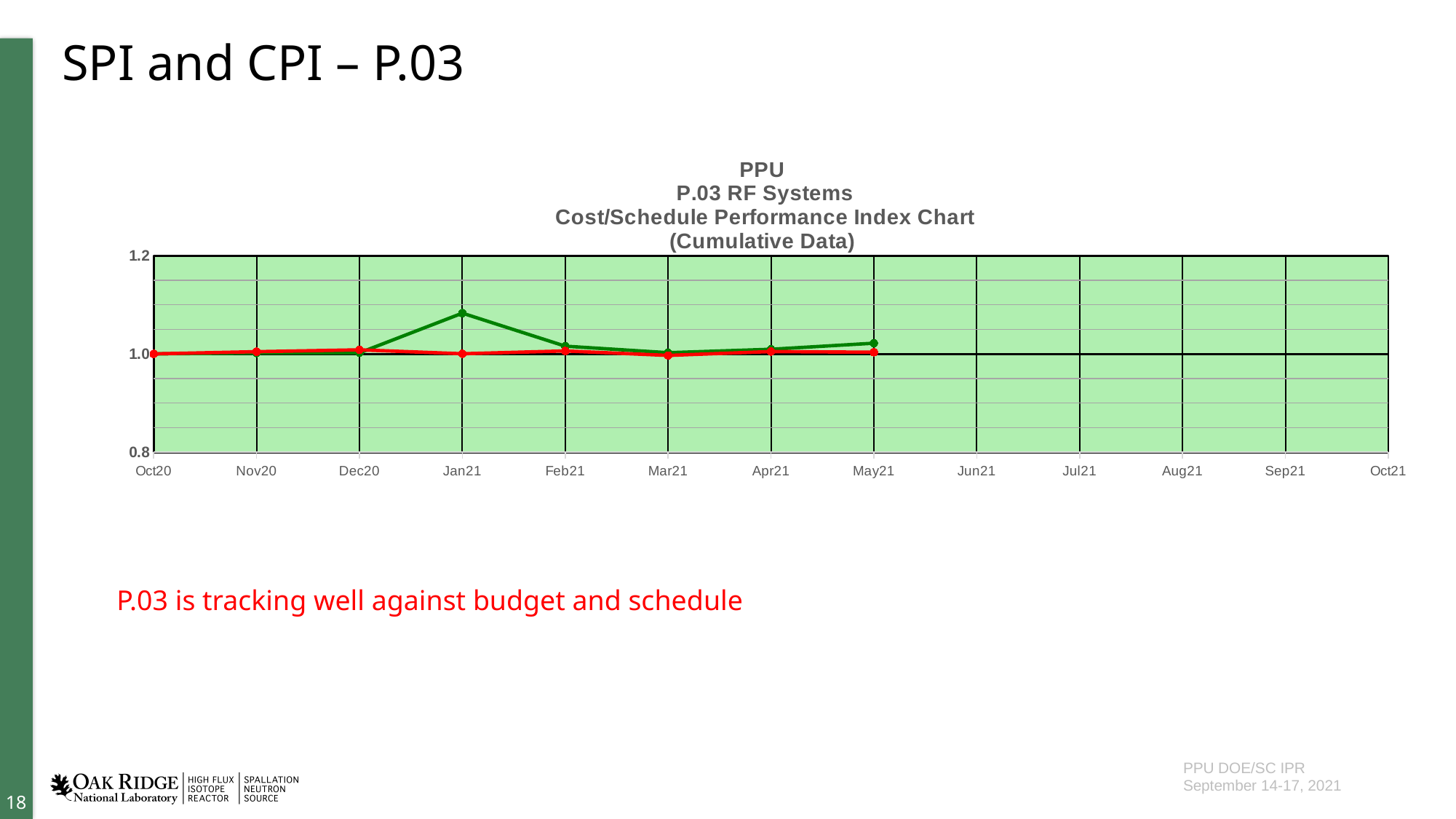
Does the green line rise or fall from Jan21 to Feb21? fall In which month does the green line reach its highest value? Jan21 What is the first month label on the x axis of the chart? Oct20 Does the green line rise or fall from Dec20 to Jan21? rise How many lines are plotted on the chart? 2 What kind of chart is shown on the slide? line chart At Jan21, which line has the larger value, the green line or the red line? green line Through which month do the plotted lines extend on the chart? May21 Is the value of the green line at Jan21 greater or less than 1.0? greater How many month labels are shown along the x axis of the chart? 13 What is the lowest value shown on the y axis of the chart? 0.8 Is the value of the green line at Jan21 greater or less than 1.2? less